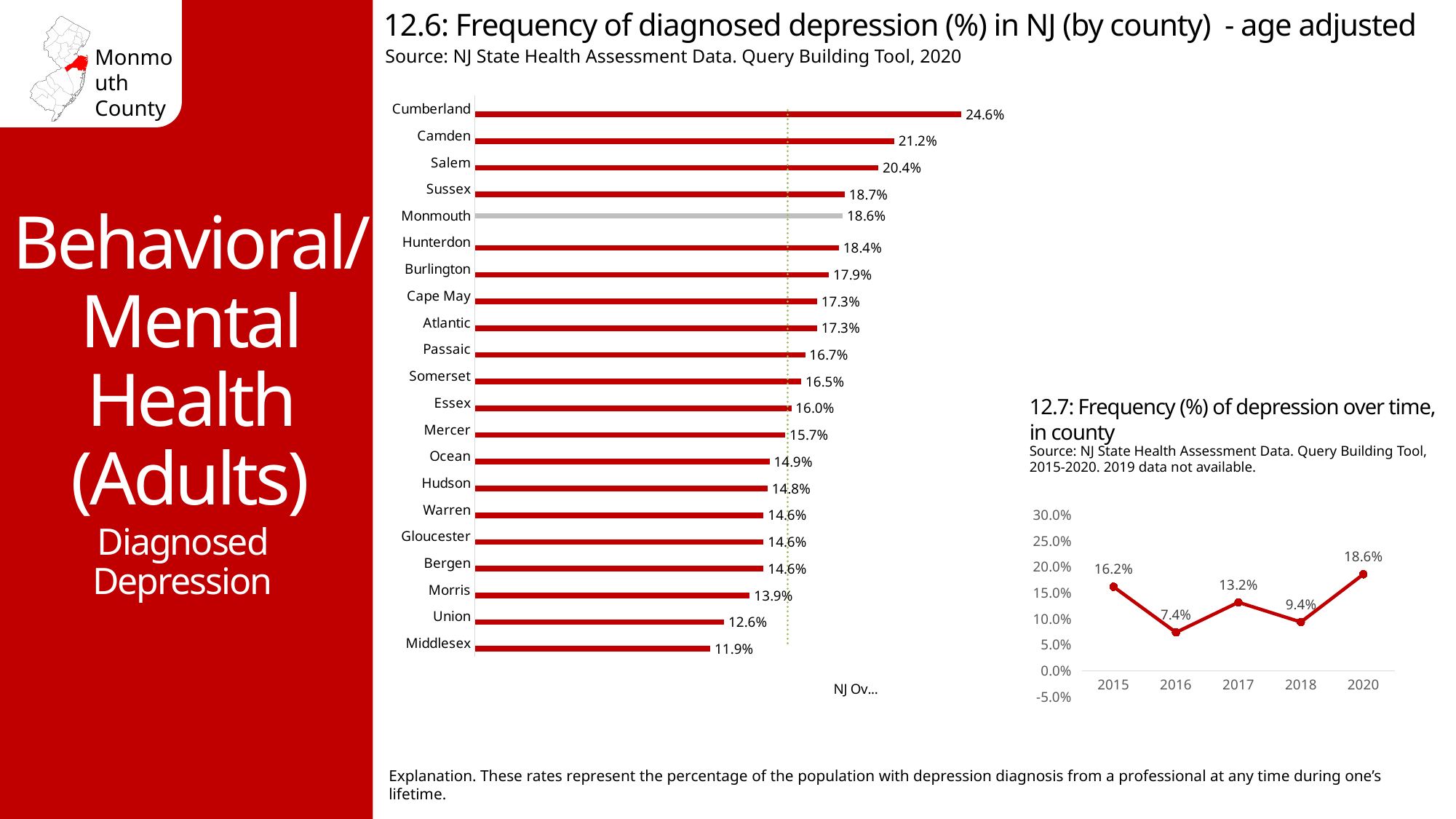
In chart 12.6, what is the difference between Cumberland and Middlesex? 12.7% In chart 12.6, what is the frequency of diagnosed depression for Monmouth? 18.6% In chart 12.6, which county has the lowest frequency of diagnosed depression? Middlesex In chart 12.7, what is the frequency of depression in 2016? 7.4% In chart 12.6, what is the value for Camden? 21.2% What kind of chart is chart 12.6? Bar chart In chart 12.6, which has a higher value, Salem or Sussex? Salem In chart 12.7, what is the difference between the 2020 and 2015 values? 2.4% In chart 12.6, which county has the highest frequency of diagnosed depression? Cumberland In chart 12.6, how many counties are shown? 21 In chart 12.7, which year has the highest frequency of depression? 2020 What kind of chart is chart 12.7? Line chart